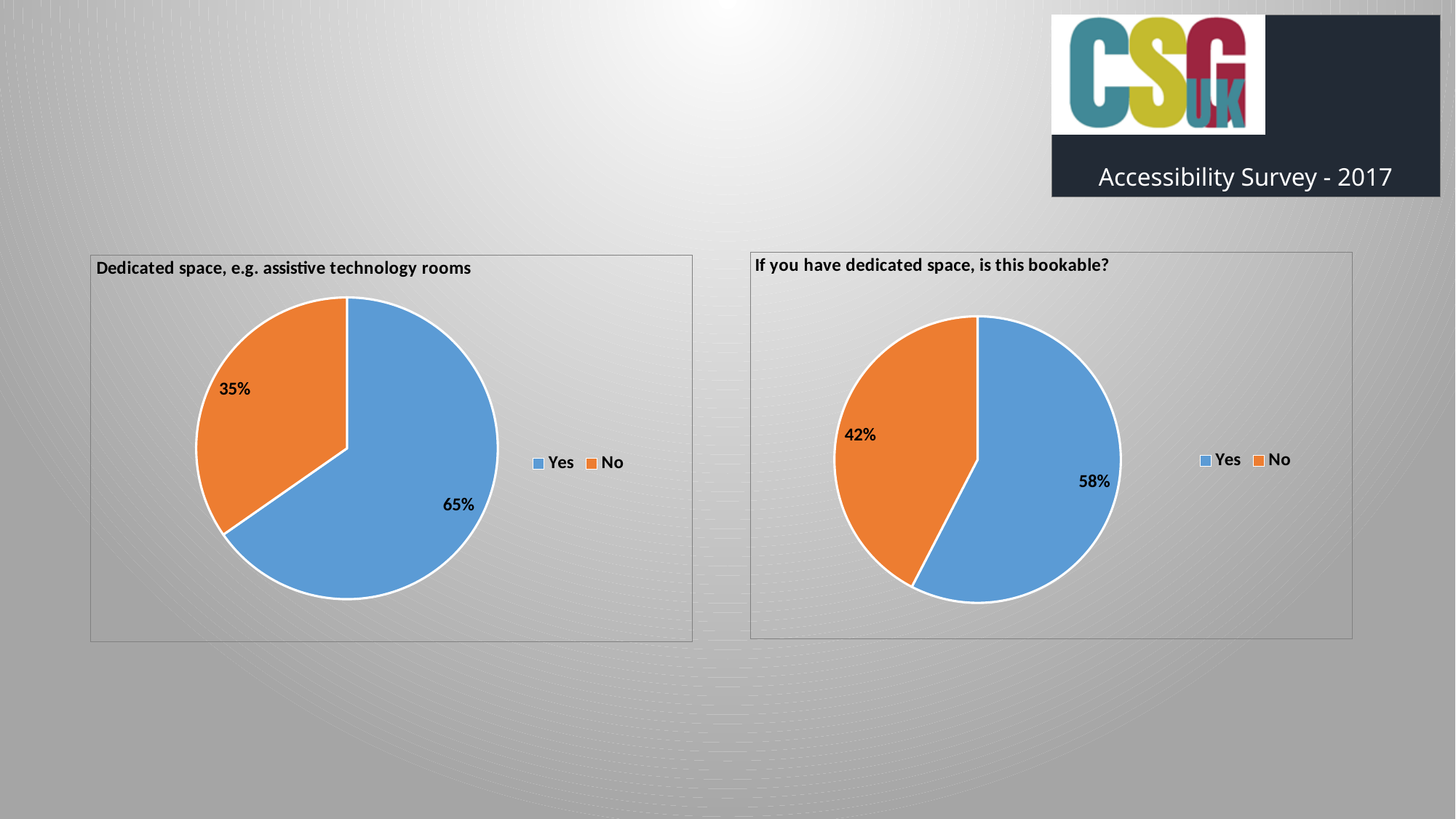
In the 'If you have dedicated space, is this bookable?' chart, what is the difference between the 'Yes' and 'No' shares? 16% In the 'If you have dedicated space, is this bookable?' chart, which slice is the smallest? No What kind of chart is the left chart on the slide? Pie chart In the 'If you have dedicated space, is this bookable?' chart, what share of the pie is 'Yes'? 58% In the 'Dedicated space, e.g. assistive technology rooms' chart, which slice is the largest? Yes How many slices does the 'Dedicated space, e.g. assistive technology rooms' pie chart have? 2 In the 'If you have dedicated space, is this bookable?' chart, which is larger, 'Yes' or 'No'? Yes In the 'Dedicated space, e.g. assistive technology rooms' chart, what share of the pie is 'Yes'? 65% In the 'Dedicated space, e.g. assistive technology rooms' chart, what is the difference between the 'Yes' and 'No' shares? 30% In the 'Dedicated space, e.g. assistive technology rooms' chart, what share of the pie is 'No'? 35% In the 'If you have dedicated space, is this bookable?' chart, what colour is the 'No' slice? Orange